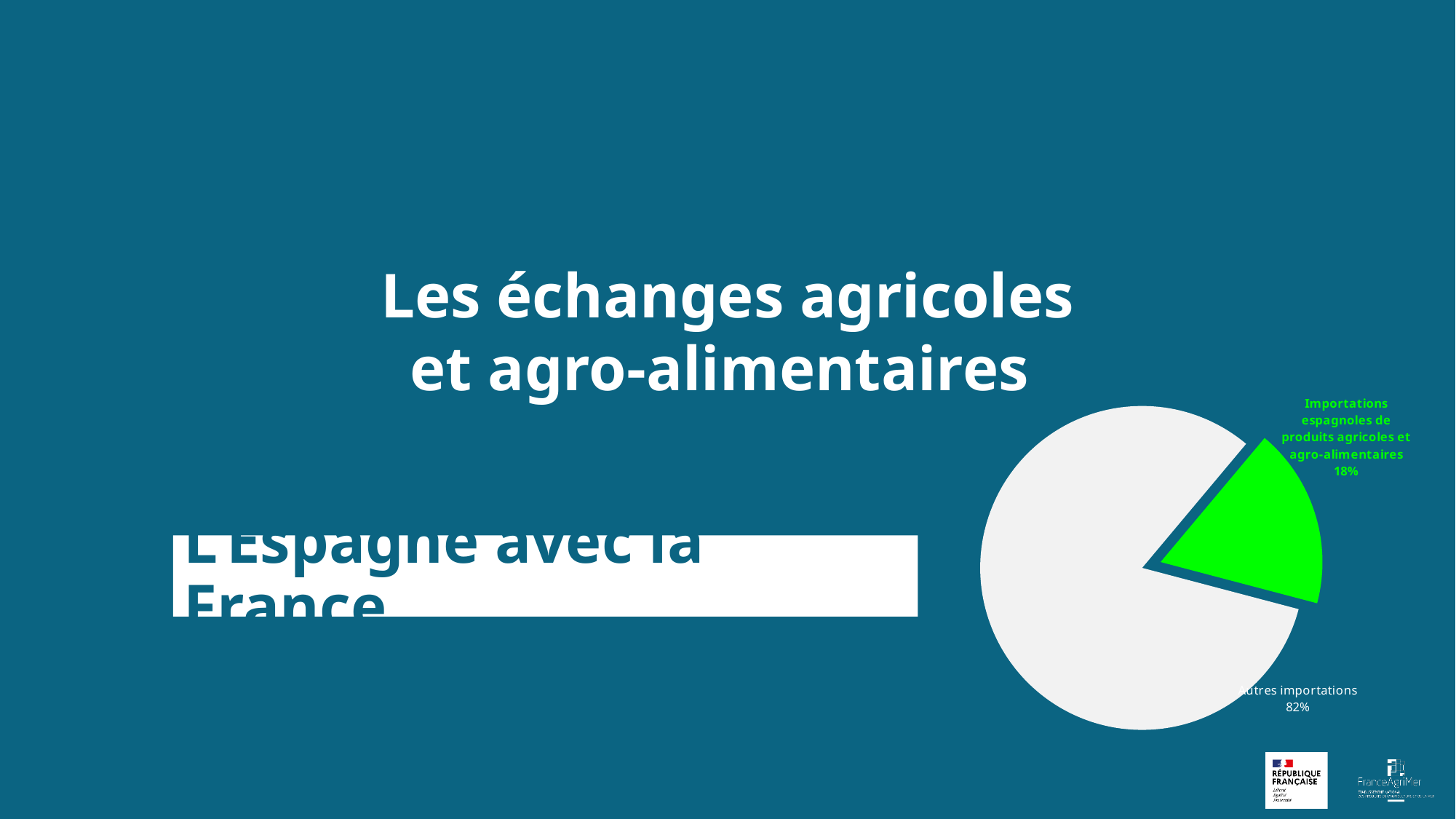
Which is larger: the "Autres importations" slice or the "Importations espagnoles de produits agricoles et agro-alimentaires" slice? Autres importations What colour is the slice for "Importations espagnoles de produits agricoles et agro-alimentaires"? green Which slice of the pie chart is the smallest? Importations espagnoles de produits agricoles et agro-alimentaires Which slice of the pie chart is the largest? Autres importations How many slices does the pie chart have? 2 What colour is the slice for "Autres importations"? light grey What is the total of the two percentages shown on the pie chart? 100% What is the difference in percentage points between the "Autres importations" slice and the "Importations espagnoles de produits agricoles et agro-alimentaires" slice? 64 percentage points What share of the pie is labelled "Importations espagnoles de produits agricoles et agro-alimentaires"? 18% What share of the pie is labelled "Autres importations"? 82% What kind of chart is shown on the slide? pie chart